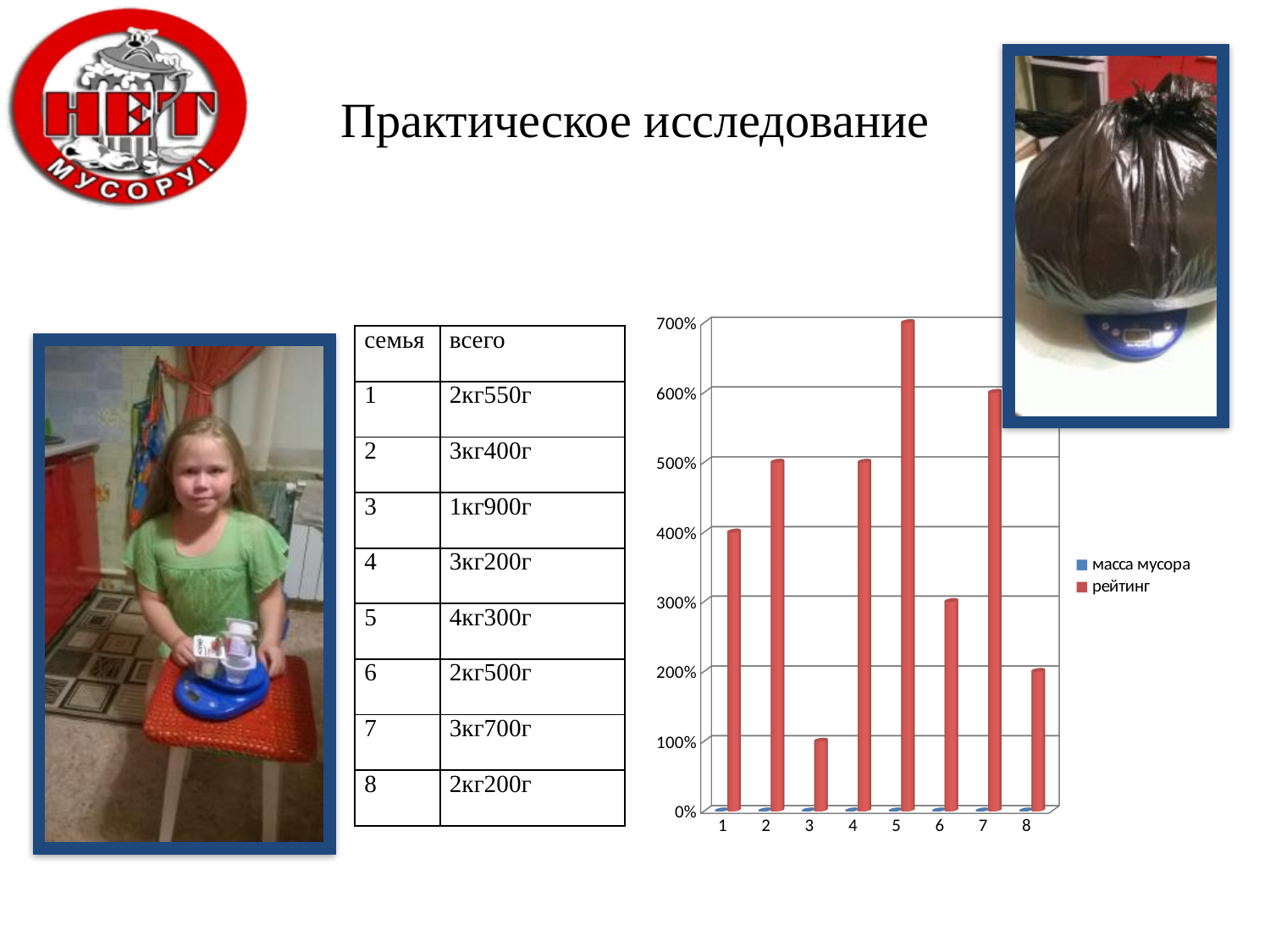
Which category has the lowest value for рейтинг? 3 What are the two series names listed in the chart legend? масса мусора, рейтинг Which category has the highest value for рейтинг? 5 What is the рейтинг value for category 5? 700% What is the difference between the рейтинг values for category 5 and category 6? 400% How many series does the chart legend list? 2 Which is larger, the рейтинг value for category 1 or for category 8? category 1 What is the рейтинг value for category 3? 100% What is the рейтинг value for category 7? 600% What kind of chart is shown on the slide? bar chart Is the рейтинг value for category 2 greater or less than 400%? greater How many categories are shown on the x axis of the chart? 8